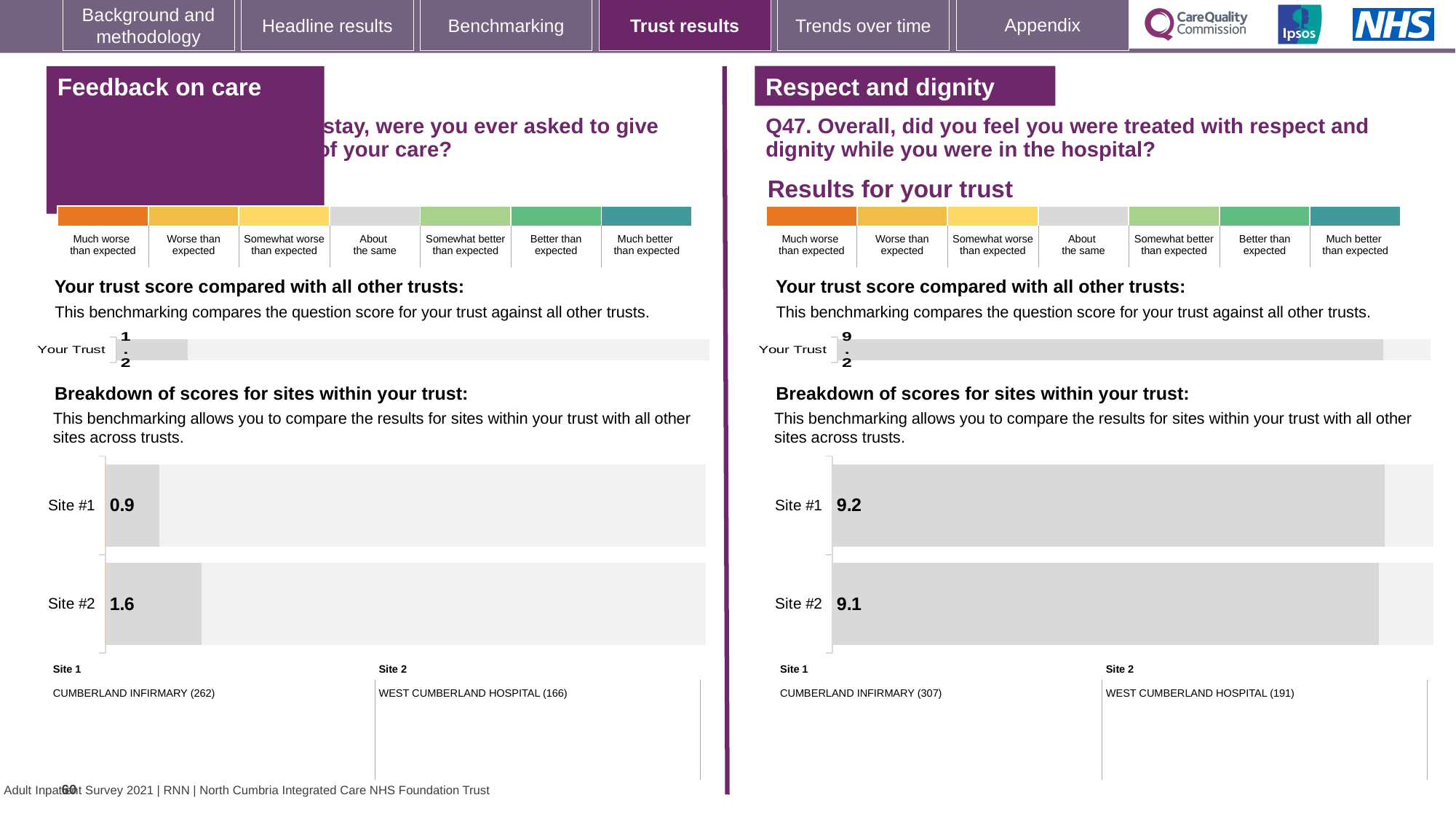
In the 'Feedback on care' breakdown of scores for sites chart, which site has the higher score? Site #2 In the 'Respect and dignity' breakdown of scores for sites chart, what is the score for Site #1? 9.2 What type of chart is used for the breakdown of scores for sites in the 'Feedback on care' section? Bar chart In the 'Feedback on care' breakdown of scores for sites chart, what is the score for Site #2? 1.6 In the 'Feedback on care' breakdown of scores for sites chart, what is the score for Site #1? 0.9 In the 'Feedback on care' section, what is the score shown for Your Trust? 1.2 In the 'Respect and dignity' section, what is the score shown for Your Trust? 9.2 In the 'Feedback on care' section, which site is listed as Site 1 below the chart? CUMBERLAND INFIRMARY (262) In the 'Respect and dignity' breakdown of scores for sites chart, what is the score for Site #2? 9.1 In the 'Feedback on care' breakdown of scores for sites chart, what is the difference between the Site #2 and Site #1 scores? 0.7 How many sites are shown in the 'Respect and dignity' breakdown of scores for sites chart? 2 In the 'Respect and dignity' breakdown of scores for sites chart, what is the difference between the Site #1 and Site #2 scores? 0.1